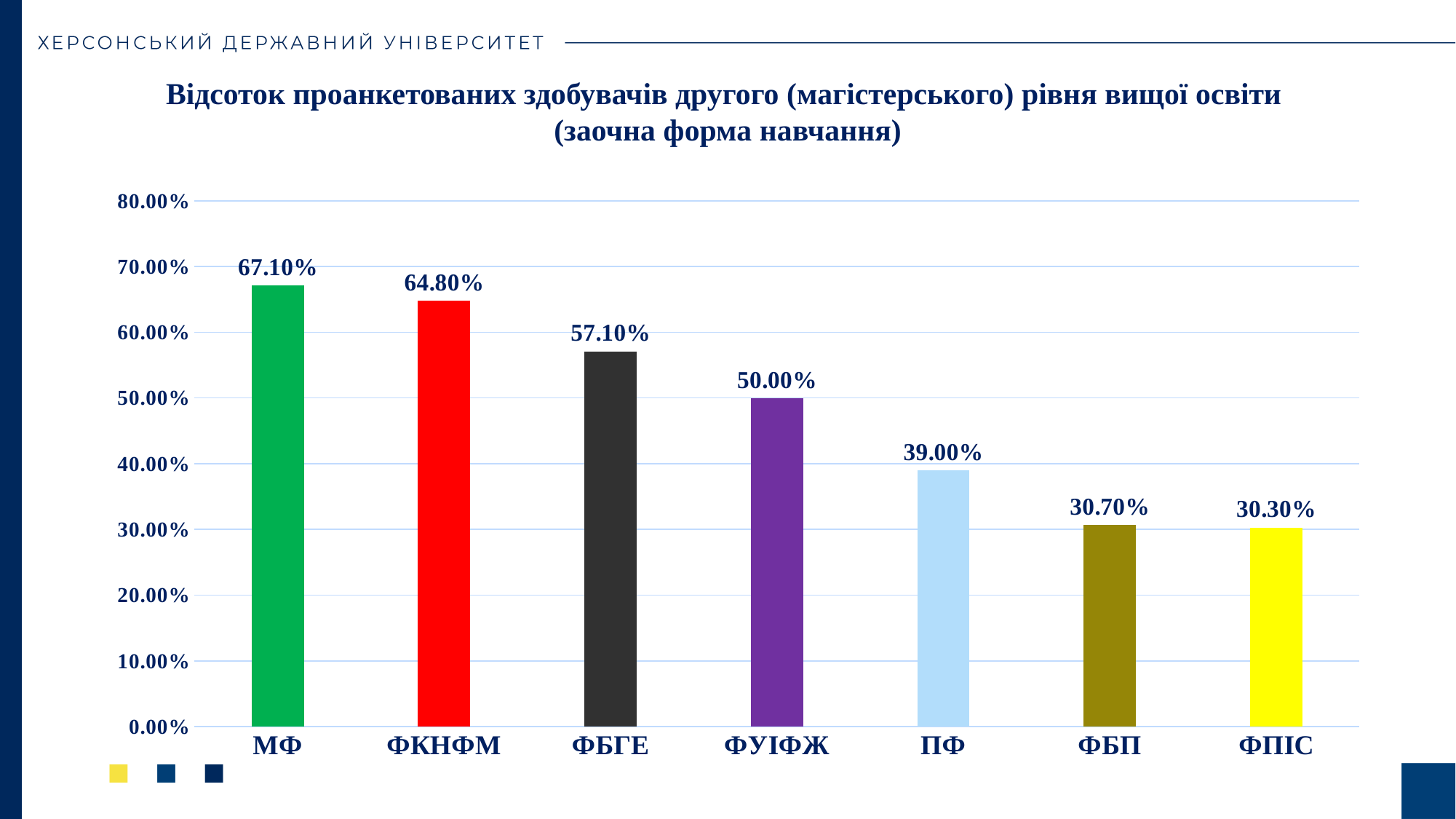
What is the value for МФ? 67.10% Is the value for ПФ greater or less than 40.00%? less Which category has the highest value? МФ Do the values rise or fall from left to right along the x axis? fall What is the value for ФУІФЖ? 50.00% What is the difference between the values for МФ and ФКНФМ? 2.30% What kind of chart is shown on the slide? bar chart Which category has the lowest value? ФПІС What is the difference between the values for ФБГЕ and ПФ? 18.10% What is the value for ФБП? 30.70% Which is larger, the value for ФБГЕ or the value for ФУІФЖ? ФБГЕ How many categories are shown on the x axis? 7